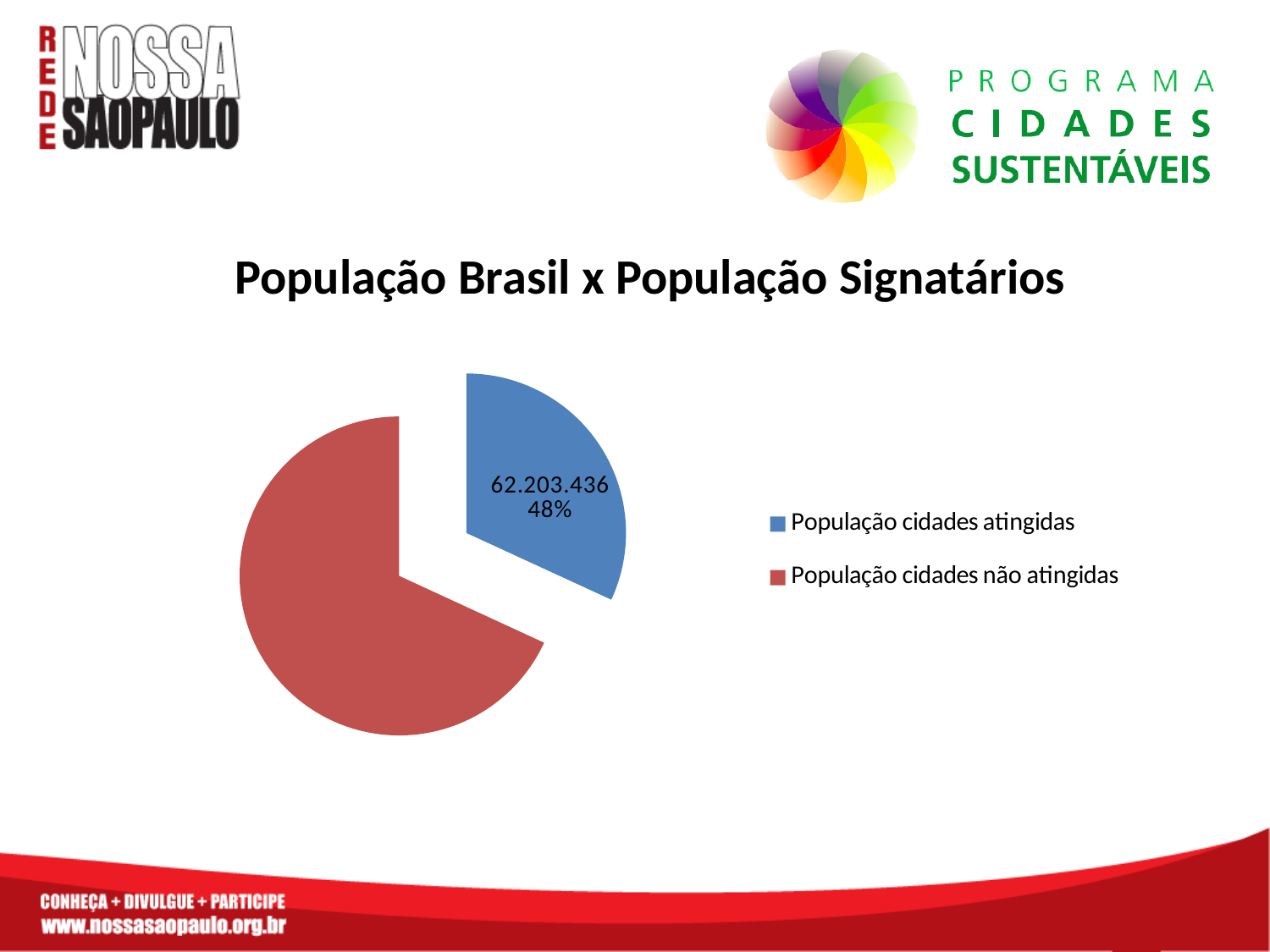
What colour is the slice for População cidades atingidas? blue What is the title of the chart? População Brasil x População Signatários What share of the pie does the slice for População cidades atingidas represent? 48% What value is printed on the slice for População cidades atingidas? 62.203.436 How many slices does the pie chart have? 2 Which slice of the pie is the smallest? População cidades atingidas Which is larger: the slice for População cidades atingidas or the slice for População cidades não atingidas? População cidades não atingidas What kind of chart is shown on the slide? pie chart Which slice of the pie is the largest? População cidades não atingidas How many entries does the legend list? 2